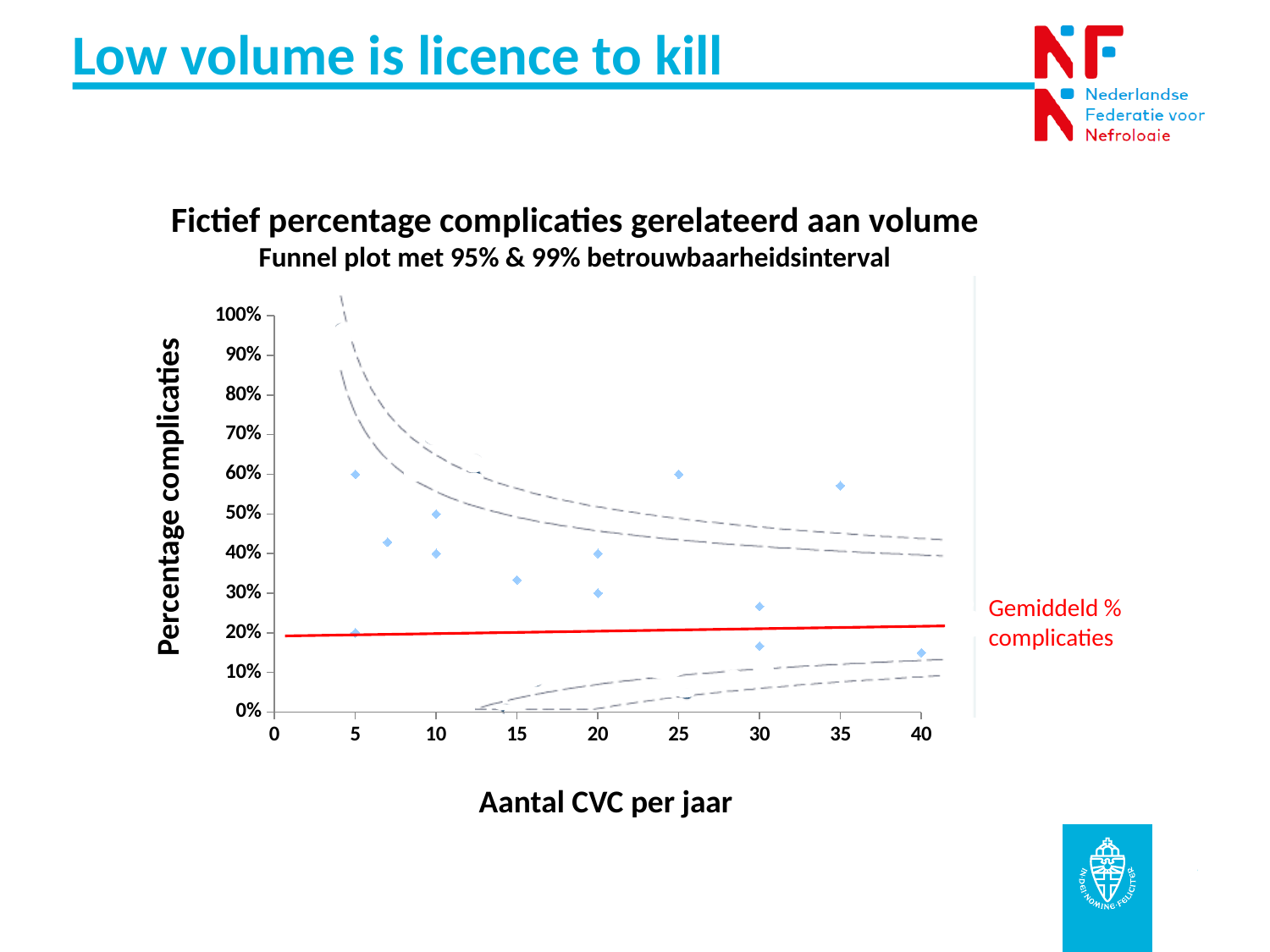
What is the title of the chart? Fictief percentage complicaties gerelateerd aan volume Is the value of the data point at 35 CVC per jaar greater or less than 50%? greater Which has the higher percentage complicaties: the data point at 25 CVC per jaar or the data point at 40 CVC per jaar? 25 CVC per jaar How many data points are plotted in the chart? 13 Is the value of the data point at 40 CVC per jaar greater or less than 20%? less What is the label of the x axis? Aantal CVC per jaar What is the maximum value shown on the y axis? 100% Is the value of the data point at 25 CVC per jaar greater or less than 50%? greater Which has the higher percentage complicaties: the data point at 35 CVC per jaar or the data point at 15 CVC per jaar? 35 CVC per jaar What kind of chart is shown on the slide? Scatter plot (funnel plot)